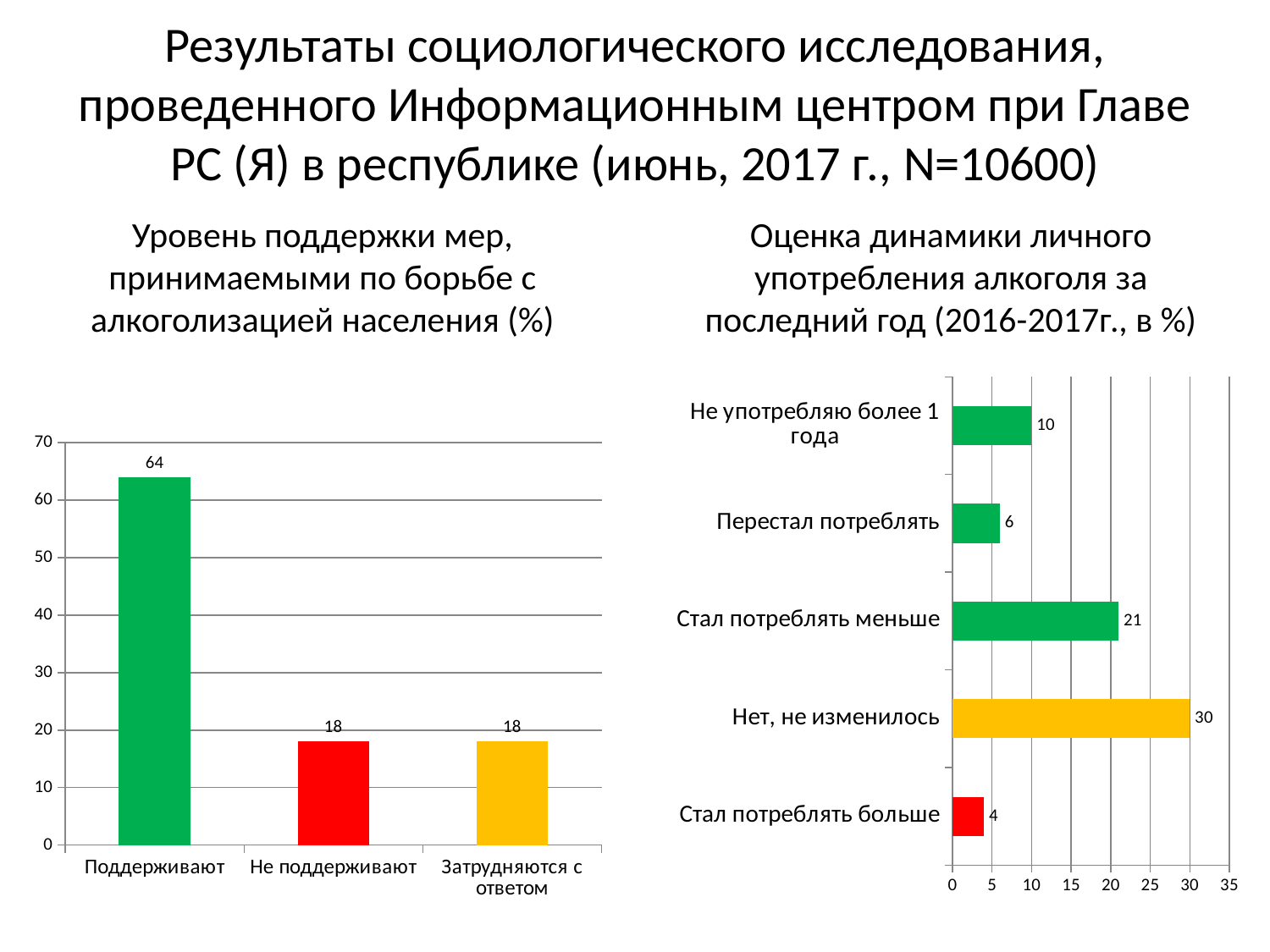
In the left chart (Уровень поддержки мер), what is the value for Не поддерживают? 18 In the left chart (Уровень поддержки мер), what kind of chart is it? bar chart In the right chart (Оценка динамики личного употребления алкоголя), which is larger: Не употребляю более 1 года or Перестал потреблять? Не употребляю более 1 года In the left chart (Уровень поддержки мер), what is the difference between Поддерживают and Затрудняются с ответом? 46 In the left chart (Уровень поддержки мер), how many categories are shown? 3 In the left chart (Уровень поддержки мер), which category has the highest value? Поддерживают In the right chart (Оценка динамики личного употребления алкоголя), what is the value for Нет, не изменилось? 30 In the right chart (Оценка динамики личного употребления алкоголя), which category has the lowest value? Стал потреблять больше In the right chart (Оценка динамики личного употребления алкоголя), what is the difference between Нет, не изменилось and Стал потреблять больше? 26 In the left chart (Уровень поддержки мер), what is the value for Поддерживают? 64 In the right chart (Оценка динамики личного употребления алкоголя), how many categories are shown? 5 In the right chart (Оценка динамики личного употребления алкоголя), what is the value for Стал потреблять меньше? 21